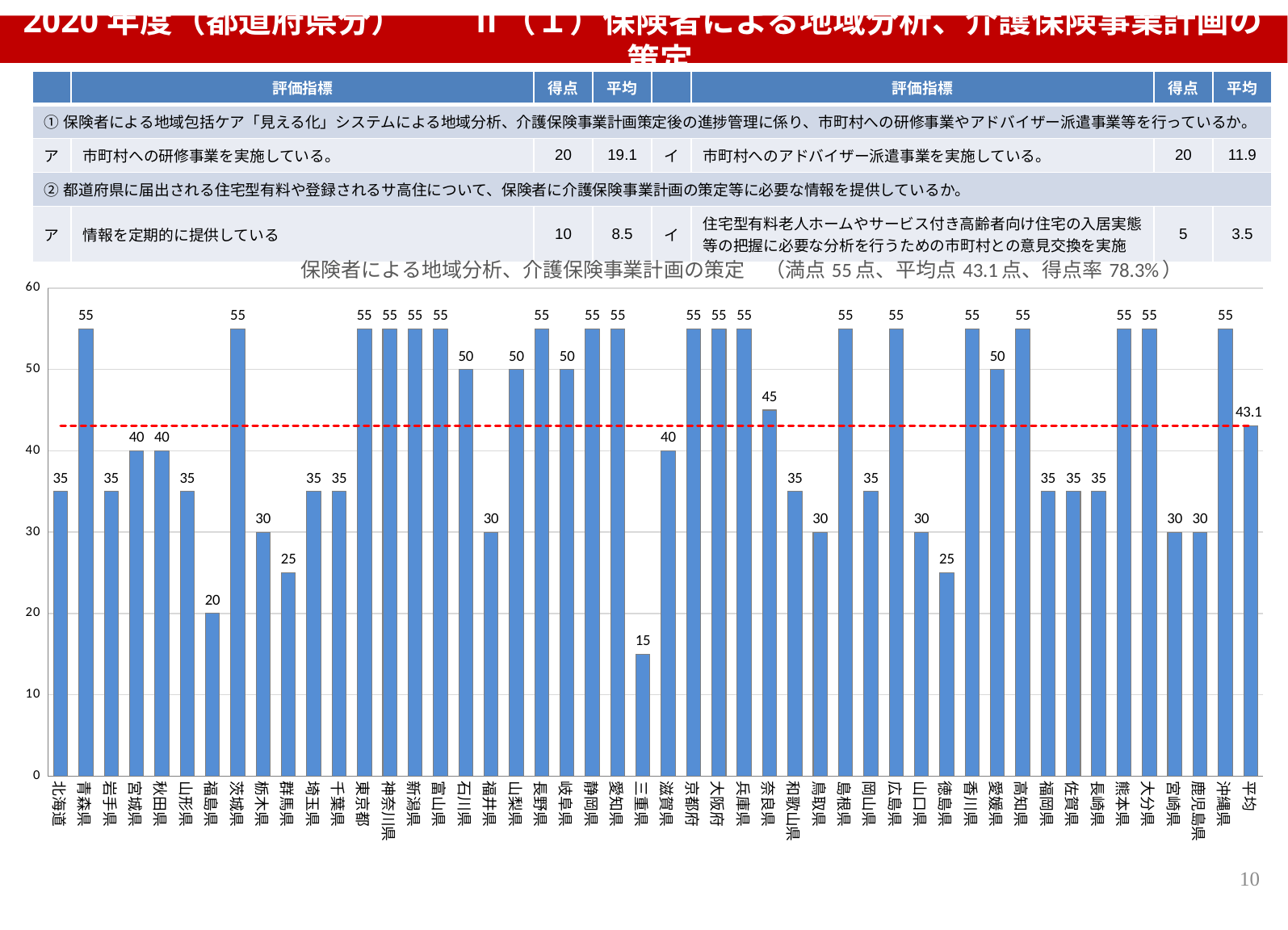
What is the value for 三重県? 15 What is the difference between the values for 福島県 and 三重県? 5 Which is larger, the value for 群馬県 or the value for 福島県? 群馬県 What is the highest value reached by any bar in the chart? 55 What is the value for 奈良県? 45 What kind of chart is shown on the slide? bar chart Is the value for 滋賀県 greater or less than 50? less What is the value for 福島県? 20 What does the red dashed horizontal line across the chart represent? 平均点 43.1 How many bars are plotted in the chart, including 平均? 48 What is the value shown for 平均 at the right end of the chart? 43.1 Which category has the lowest value in the chart? 三重県